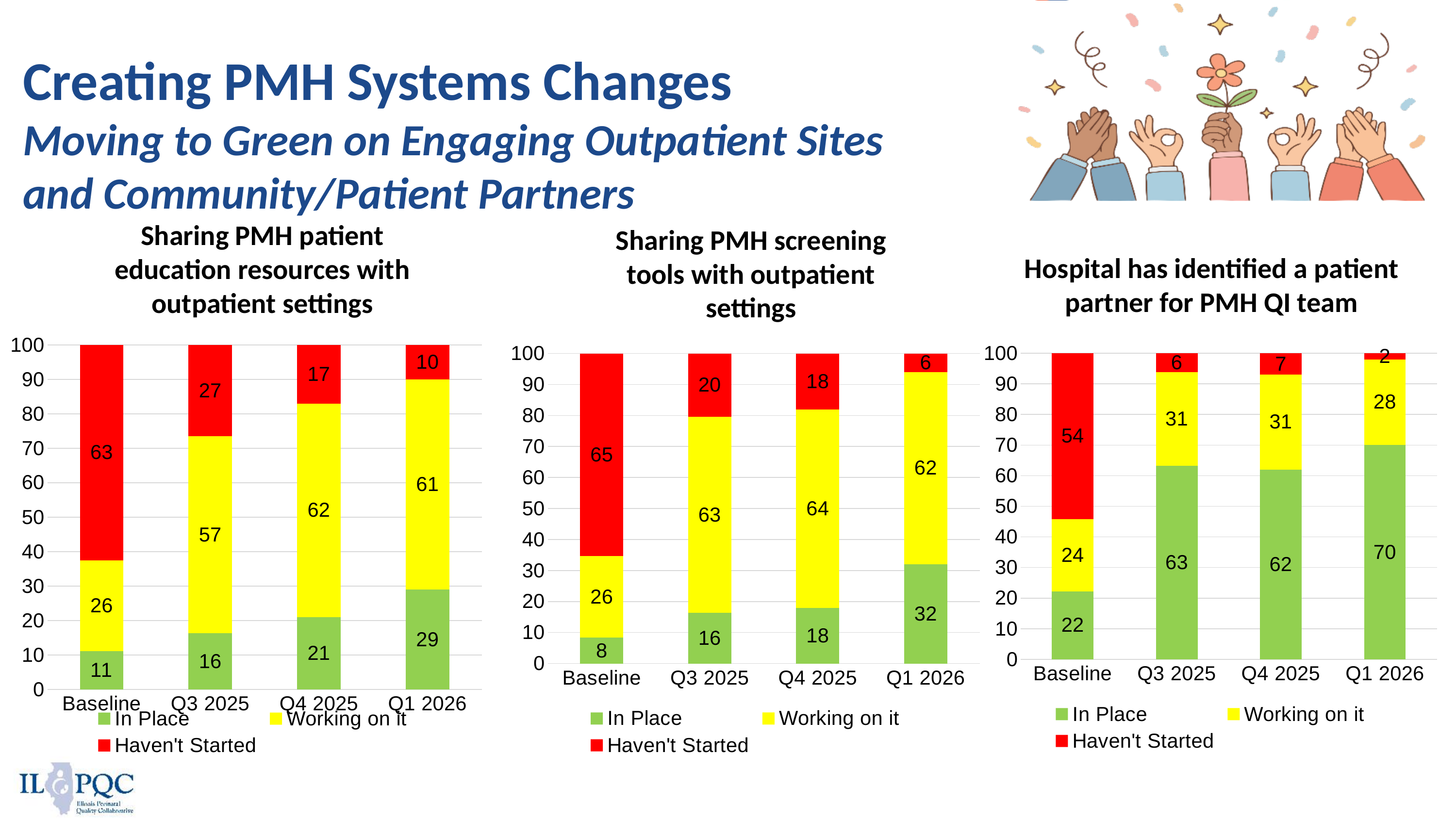
How many periods are shown on the x axis of the 'Sharing PMH screening tools with outpatient settings' chart? 4 In the 'Sharing PMH screening tools with outpatient settings' chart, which period has the lowest In Place value? Baseline What type of chart is the 'Sharing PMH patient education resources with outpatient settings' chart? Stacked bar chart In the 'Sharing PMH screening tools with outpatient settings' chart, what is the Working on it value for Q4 2025? 64 In the 'Sharing PMH screening tools with outpatient settings' chart, is the In Place value larger for Q3 2025 or Q1 2026? Q1 2026 In the 'Hospital has identified a patient partner for PMH QI team' chart, what is the total of the stacked bar for Q3 2025? 100 In the 'Hospital has identified a patient partner for PMH QI team' chart, which period has the highest In Place value? Q1 2026 In the 'Sharing PMH patient education resources with outpatient settings' chart, what is the In Place value for Q1 2026? 29 How many series does the legend list for the 'Hospital has identified a patient partner for PMH QI team' chart? 3 In the 'Hospital has identified a patient partner for PMH QI team' chart, what is the Haven't Started value for Q1 2026? 2 In the 'Sharing PMH patient education resources with outpatient settings' chart, what is the difference between the Haven't Started values at Baseline and Q1 2026? 53 In the 'Sharing PMH patient education resources with outpatient settings' chart, what is the Haven't Started value at Baseline? 63